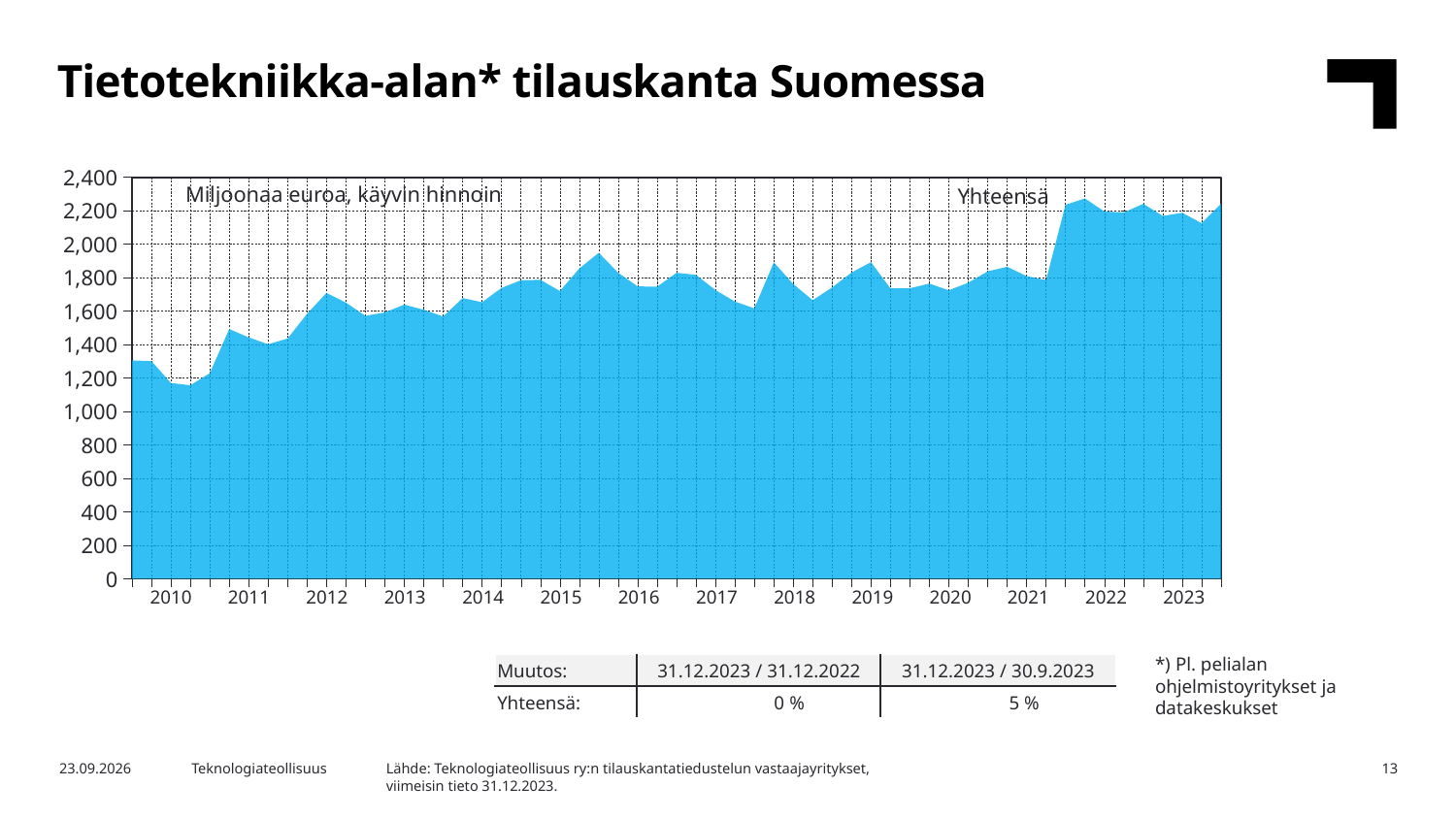
What is the highest value shown on the y axis of the chart? 2,400 How many years are labelled on the x axis of the chart? 14 Which year is the last one labelled on the x axis? 2023 Which year is the first one labelled on the x axis? 2010 What kind of chart is shown on the slide? area chart Overall, do the values rise or fall from 2010 to 2023? rise What is the title of the chart on the slide? Tietotekniikka-alan* tilauskanta Suomessa What unit is the chart's data expressed in, according to the label inside the plot area? Miljoonaa euroa, käyvin hinnoin Which year has higher values, 2010 or 2022? 2022 Is the value in 2022 greater or less than 2,000? greater In which year does the chart reach its lowest values? 2010 Is the value in 2020 greater or less than 2,000? less